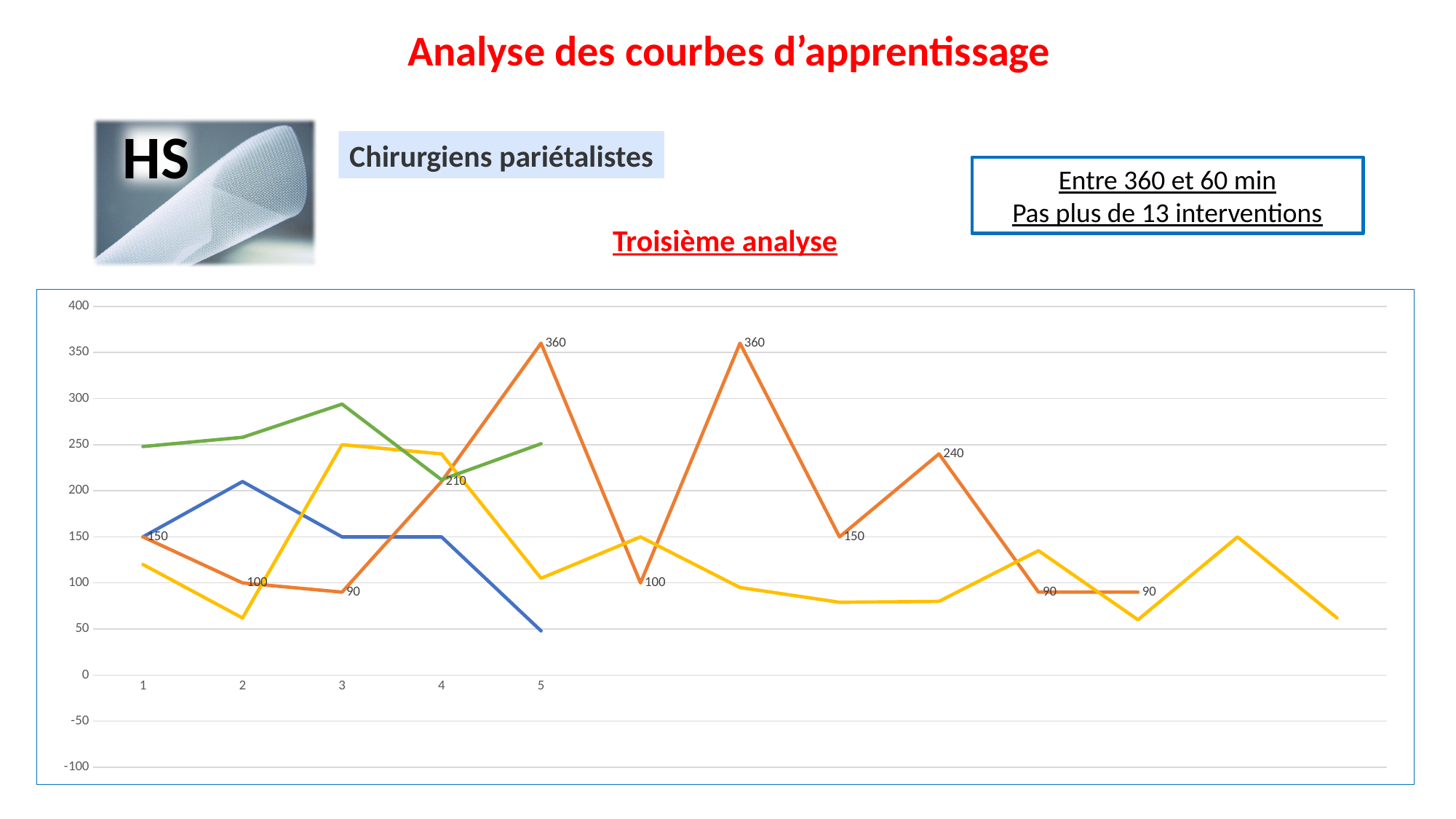
What is the lowest data label shown on the orange line? 90 Does the blue line rise or fall between x = 3 and x = 5? fall What is the value of the orange line at x = 5? 360 What is the difference between the orange line's values at x = 5 and x = 1? 210 What is the highest data label shown on the orange line? 360 Which is larger for the orange line: the value at x = 4 or the value at x = 2? x = 4 What is the value of the orange line at x = 1? 150 How many lines are plotted on the chart? 4 Is the value of the green line at x = 3 greater or less than 250? greater What is the value of the orange line at x = 3? 90 What kind of chart is shown on the slide? line chart Is the value of the blue line at x = 5 greater or less than 100? less